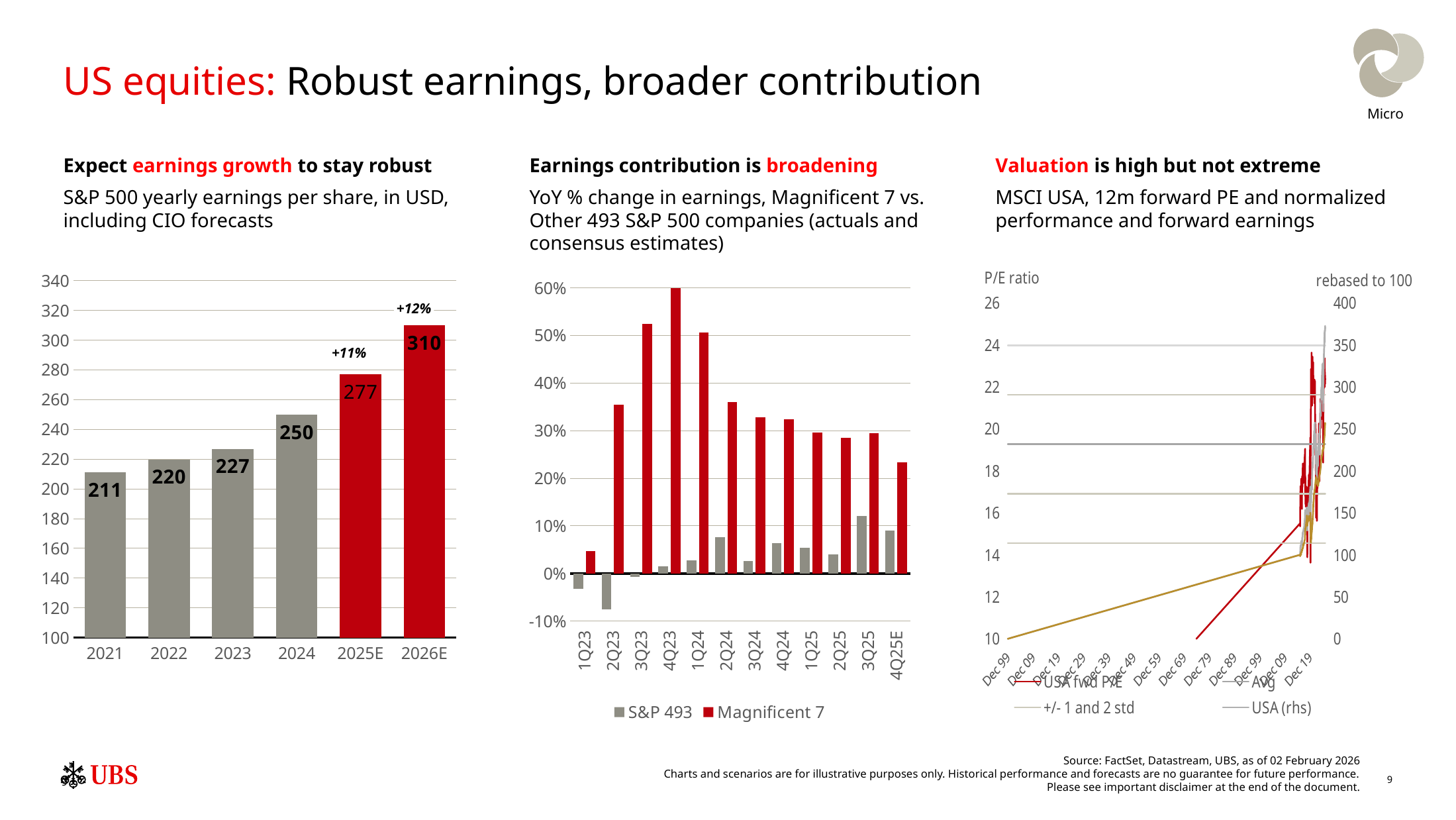
In the left chart (S&P 500 yearly earnings per share), what is the difference between the 2025E and 2024 values? 27 In the middle chart (YoY % change in earnings), is the Magnificent 7 value for 2Q23 greater or less than 30%? greater In the left chart (S&P 500 yearly earnings per share), which year has the lowest earnings per share? 2021 In the left chart (S&P 500 yearly earnings per share), what is the value for 2024? 250 In the left chart (S&P 500 yearly earnings per share), do the values rise or fall from 2021 to 2026E? rise In the middle chart (YoY % change in earnings), how many series does the legend list? 2 What kind of chart is the right chart (MSCI USA, 12m forward PE)? line chart In the left chart (S&P 500 yearly earnings per share), what is the forecast value for 2026E? 310 In the middle chart (YoY % change in earnings), which series is larger in 3Q25, S&P 493 or Magnificent 7? Magnificent 7 In the left chart (S&P 500 yearly earnings per share), how many years are shown on the x axis? 6 In the left chart (S&P 500 yearly earnings per share), what growth percentage is printed above the 2025E bar? +11% In the middle chart (YoY % change in earnings), which quarter has the highest Magnificent 7 value? 4Q23